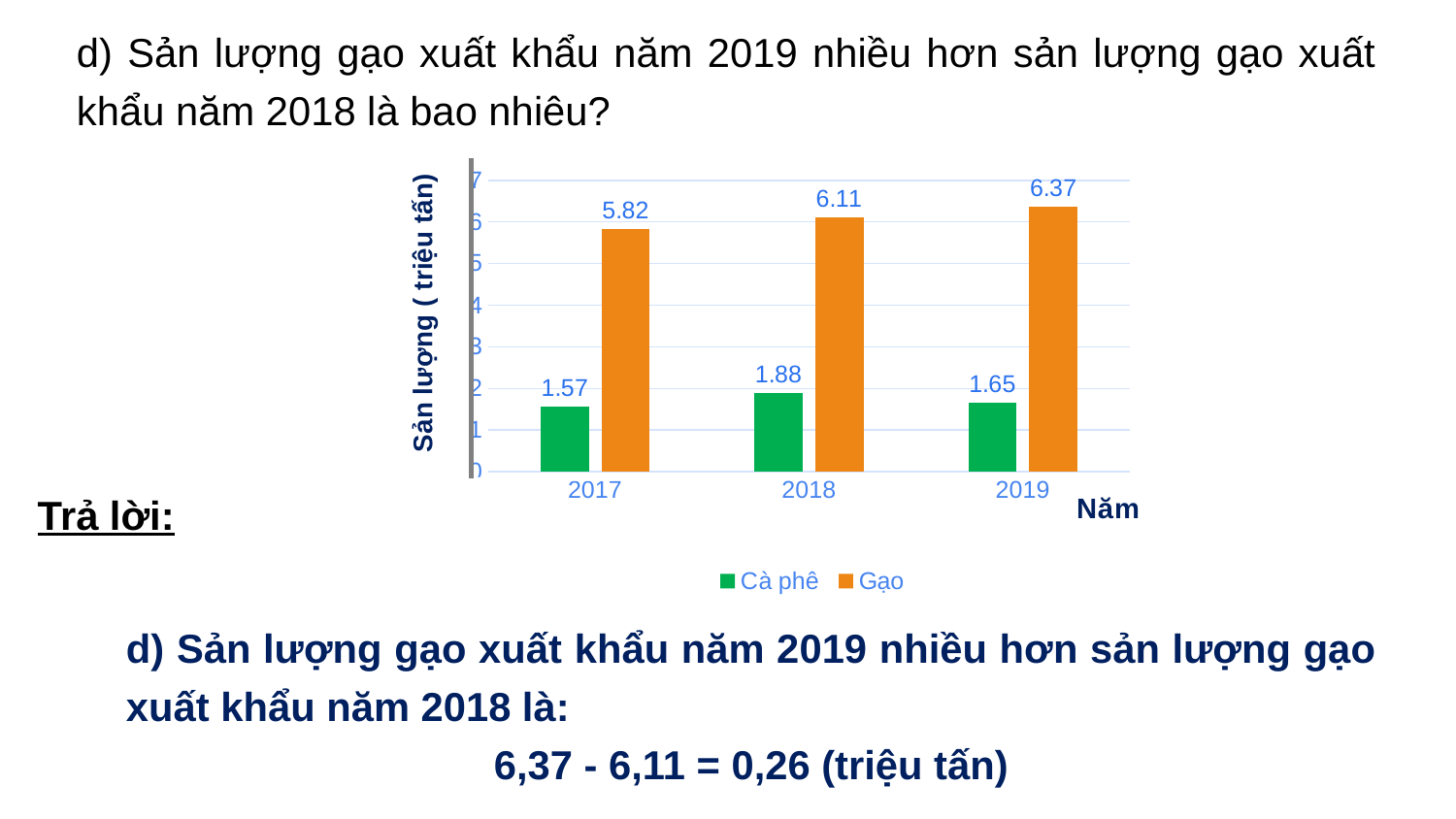
What is the value for Gạo in 2019? 6.37 Which year has the highest value for Cà phê? 2018 Which is larger, the Cà phê value for 2017 or for 2019? 2019 What is the label of the y axis? Sản lượng ( triệu tấn) Do the Gạo values rise or fall from 2017 to 2019? rise What is the value for Gạo in 2017? 5.82 How many years are shown on the x axis? 3 How many series does the legend list? 2 What kind of chart is shown? bar chart What is the difference between the Gạo values for 2019 and 2018? 0.26 Which year has the lowest value for Gạo? 2017 What is the value for Cà phê in 2018? 1.88